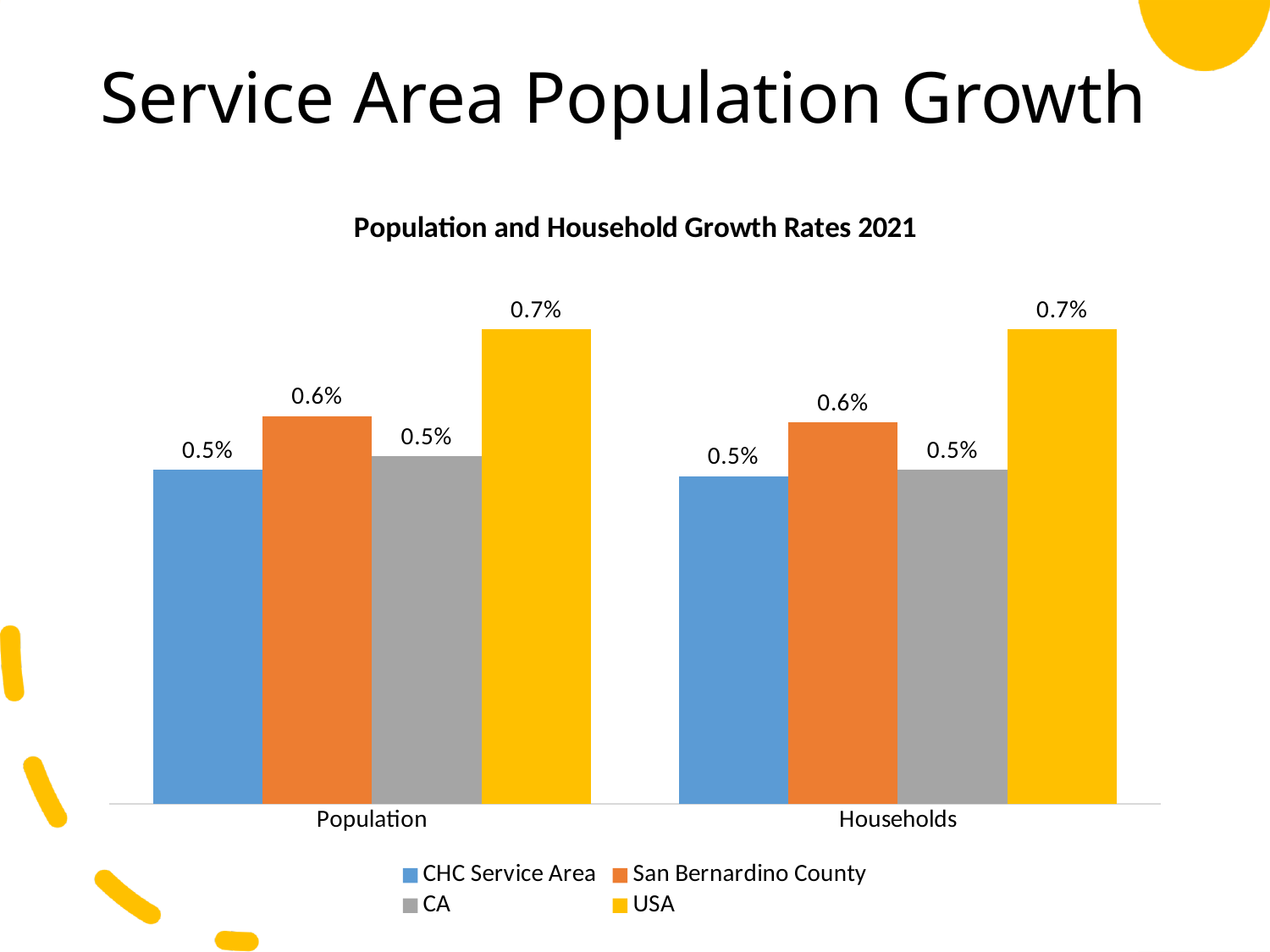
What is the value for CHC Service Area in the Population category? 0.5% What is the value for USA in the Population category? 0.7% How many categories are shown on the x axis? 2 What kind of chart is shown on the slide? Bar chart In the Population category, which is larger: San Bernardino County or CHC Service Area? San Bernardino County How many series does the legend list? 4 What is the value for San Bernardino County in the Households category? 0.6% What is the difference between the USA and CHC Service Area values in the Population category? 0.2% Which series has the highest value in the Population category? USA What is the value for CA in the Households category? 0.5% Which series has the highest value in the Households category? USA What is the difference between the USA and San Bernardino County values in the Households category? 0.1%